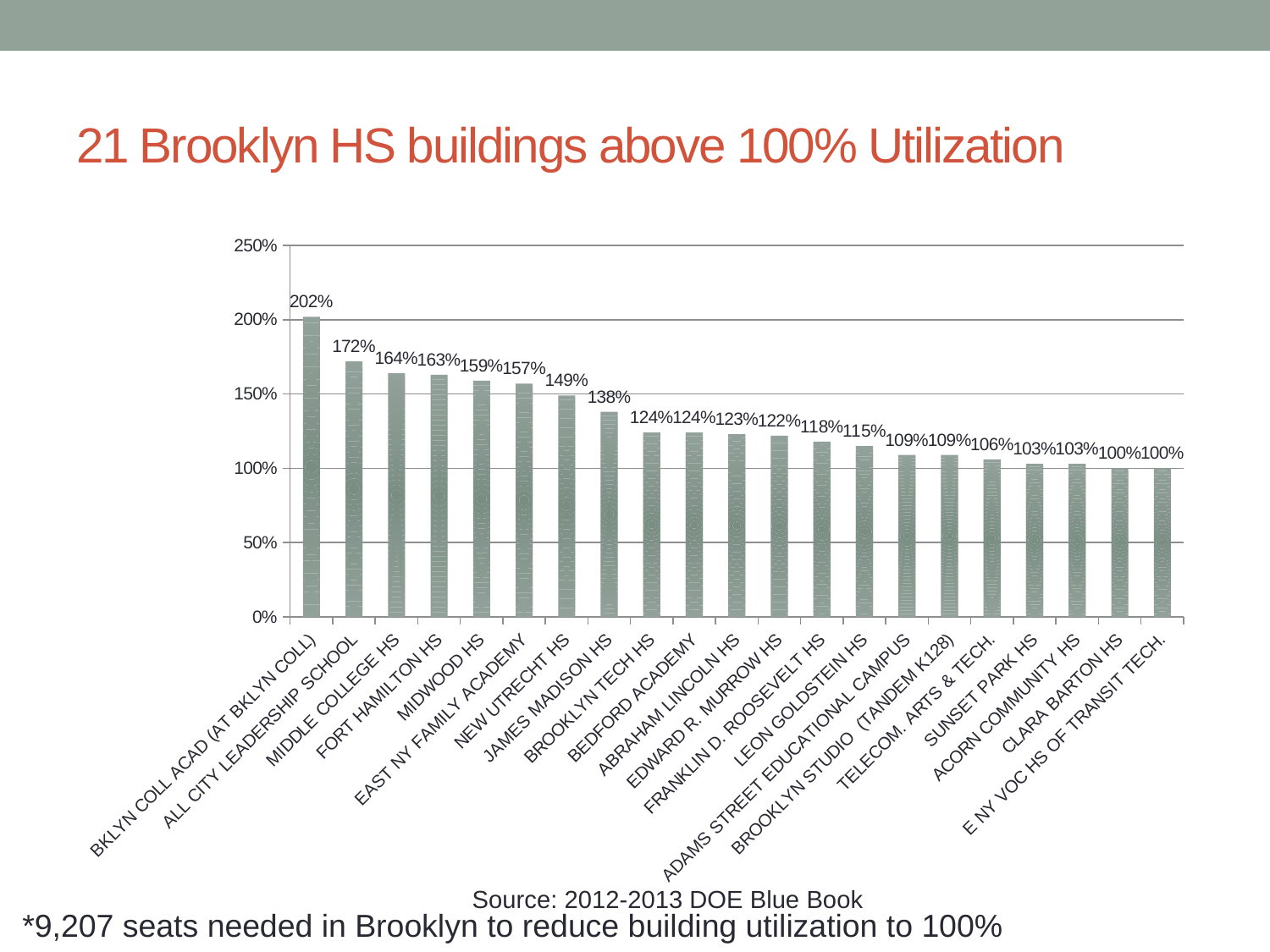
What is the utilization value for LEON GOLDSTEIN HS? 115% What is the utilization value for FORT HAMILTON HS? 163% What is the title of the slide? 21 Brooklyn HS buildings above 100% Utilization Is the value for BROOKLYN TECH HS greater or less than 150%? less Which has a higher utilization, MIDWOOD HS or NEW UTRECHT HS? MIDWOOD HS Which building has the highest utilization? BKLYN COLL ACAD (AT BKLYN COLL) How many buildings are shown on the chart? 21 Do the values rise or fall from left to right along the x axis? fall What is the highest utilization value shown on the chart? 202% What is the difference in utilization between BKLYN COLL ACAD (AT BKLYN COLL) and ALL CITY LEADERSHIP SCHOOL? 30% What kind of chart is shown on the slide? bar chart What is the utilization value for JAMES MADISON HS? 138%